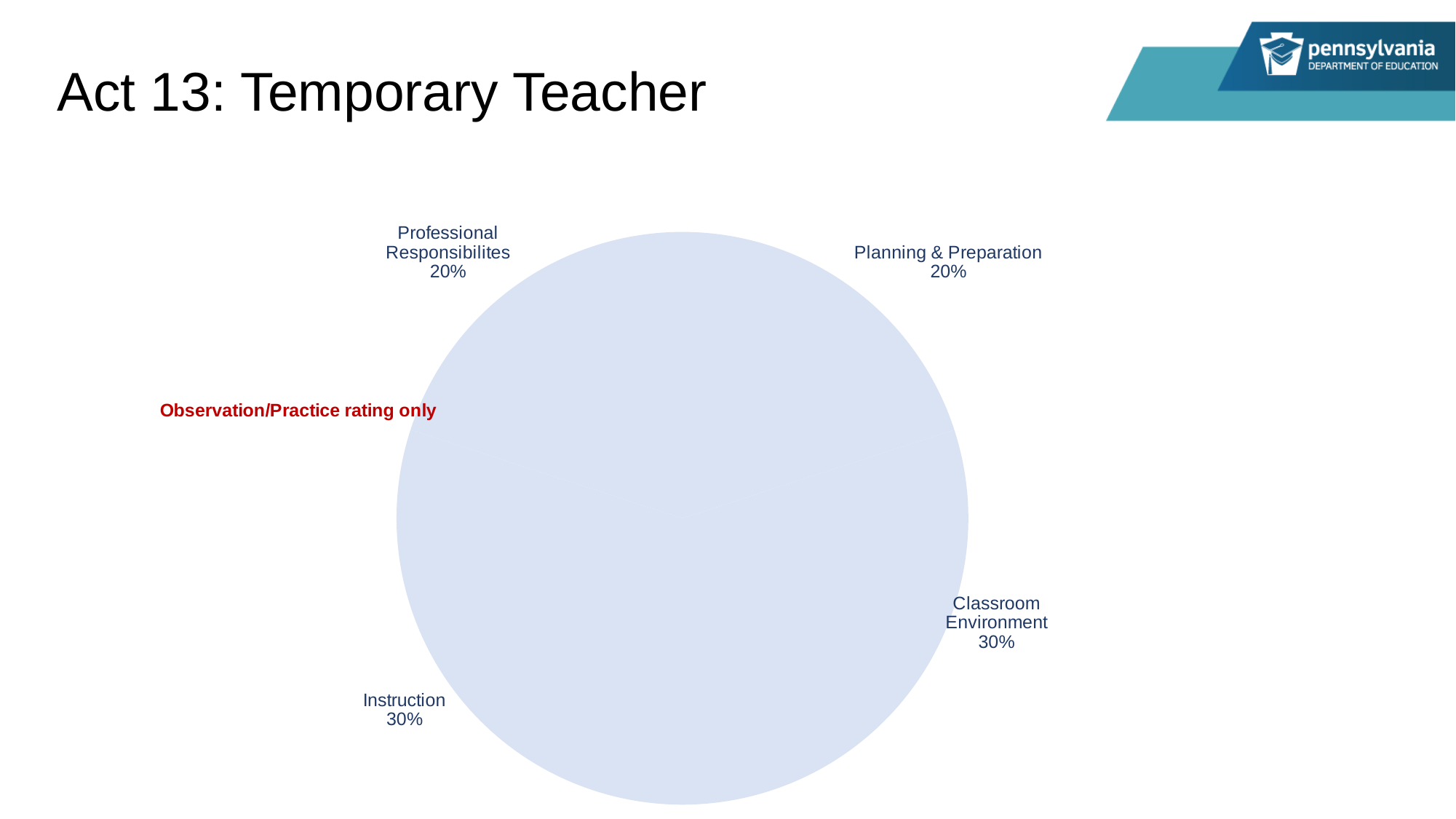
What share of the pie does Instruction have? 30% Which categories have the largest share of the pie? Classroom Environment and Instruction How many categories does the pie chart show? 4 What is the combined share of Instruction and Classroom Environment? 60% What share of the pie does Planning & Preparation have? 20% What kind of chart is shown on the slide? pie chart What is the value shown for Classroom Environment? 30% What is the value shown for Professional Responsibilites? 20% Which is larger, Instruction or Planning & Preparation? Instruction What is the difference between the Classroom Environment share and the Professional Responsibilites share? 10% What text in red appears to the left of the pie chart? Observation/Practice rating only Which categories have the smallest share of the pie? Professional Responsibilites and Planning & Preparation